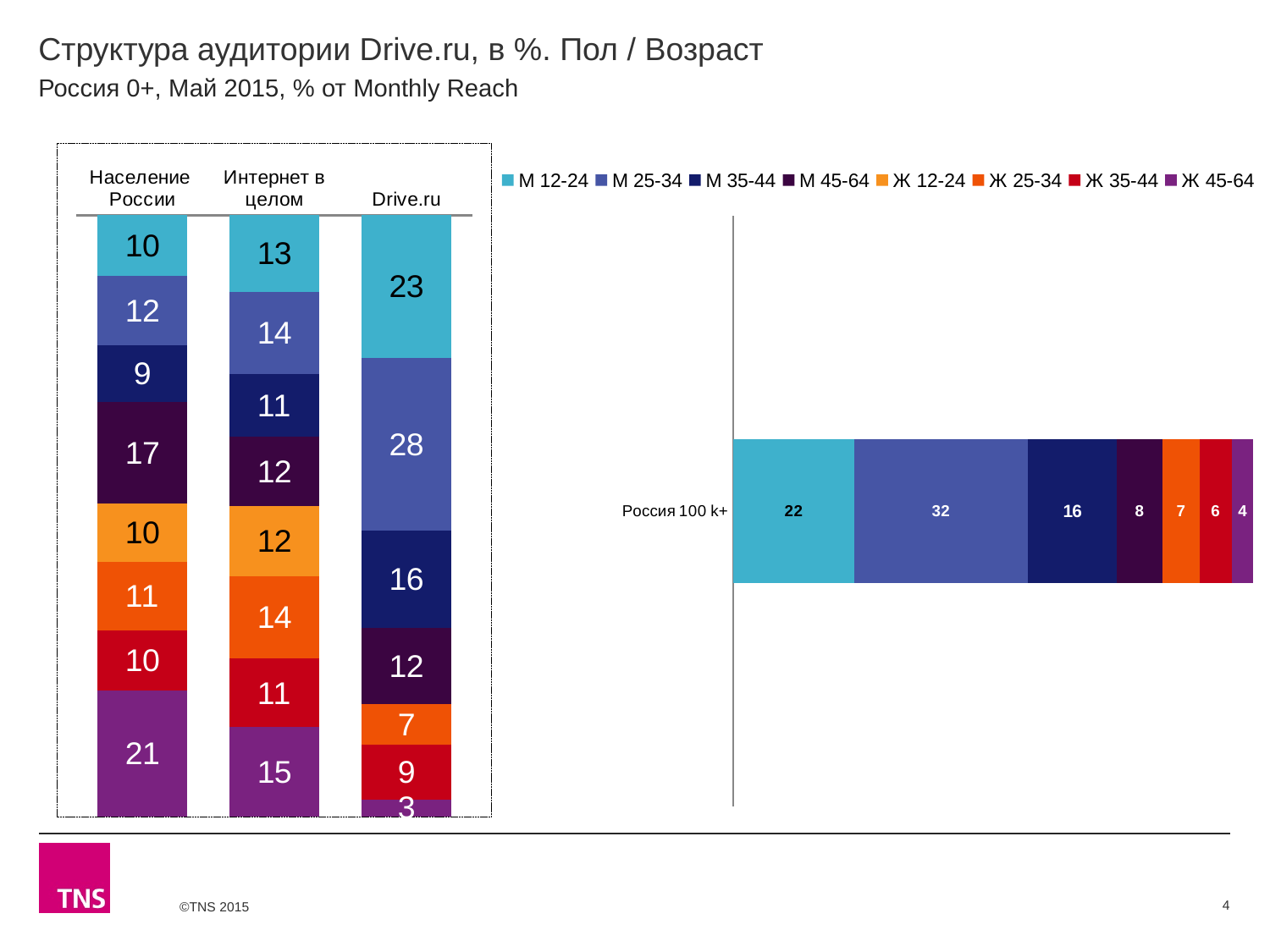
In the left chart, what is the difference between the М 12-24 value for Drive.ru and the М 12-24 value for Население России? 13 In the left chart, what is the value of the М 25-34 segment for Drive.ru? 28 In the right chart (Россия 100 k+), which series has the largest segment? М 25-34 In the left chart, which has the larger Ж 45-64 value: Население России or Интернет в целом? Население России In the left chart, what is the value of the М 45-64 segment for Население России? 17 How many bars (categories) are shown in the left chart? 3 In the left chart, what is the total of all segments in the Население России bar? 100 In the left chart, what is the value of the Ж 45-64 segment for Интернет в целом? 15 How many series does the legend list? 8 In the right chart (Россия 100 k+), what is the value of the М 25-34 segment? 32 In the left chart, which series has the largest segment in the Drive.ru bar? М 25-34 In the right chart (Россия 100 k+), what is the value of the М 35-44 segment? 16